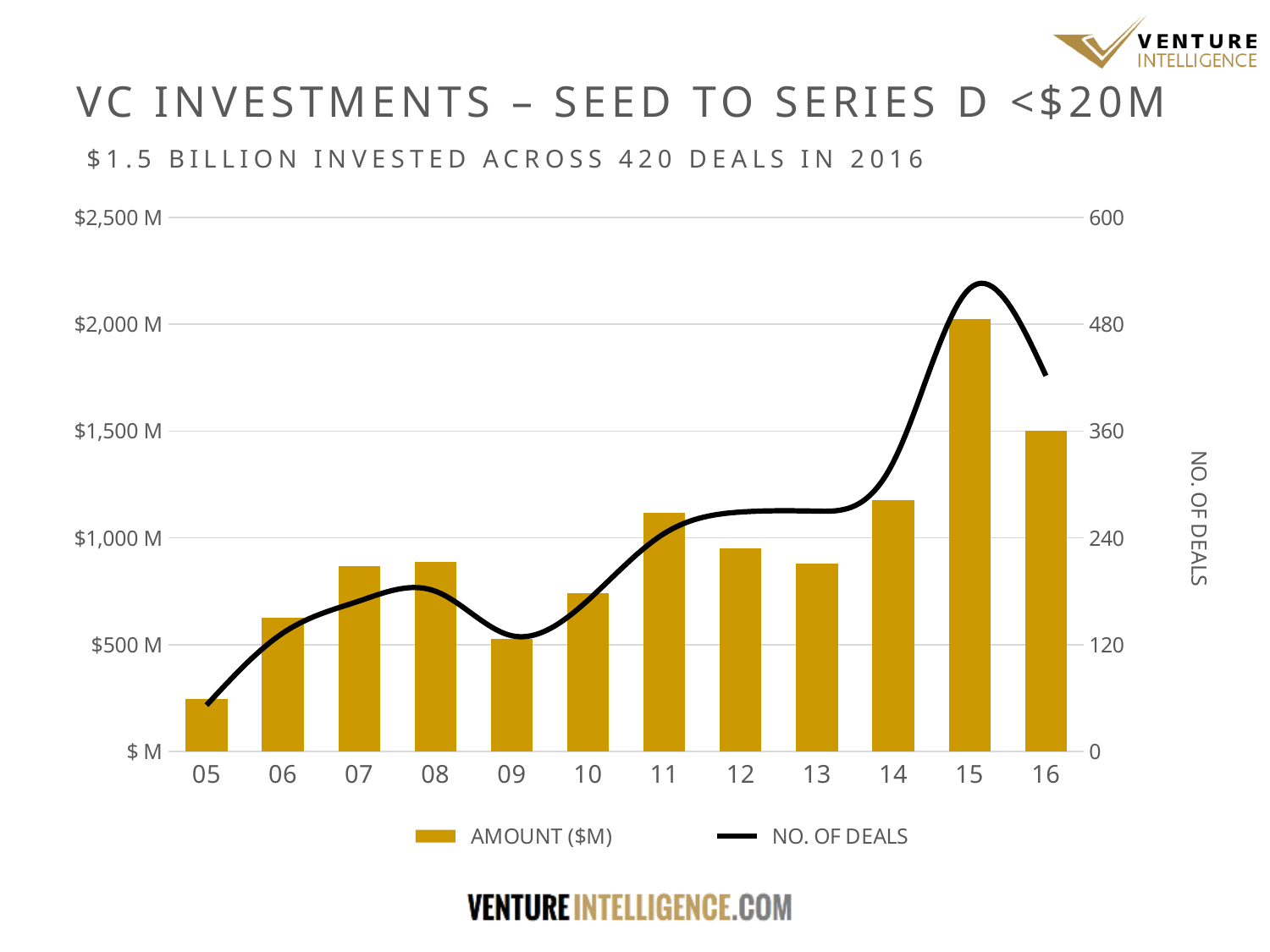
Which year has the lowest AMOUNT ($M) bar? 05 Is the AMOUNT ($M) for 14 greater or less than $1,000 M? greater What kind of chart is this? Combination bar and line chart Does the AMOUNT ($M) rise or fall from 05 to 08? rise Is the AMOUNT ($M) for 07 greater or less than $500 M? greater How many series does the legend list? 2 Which year has the highest AMOUNT ($M) bar? 15 Is the AMOUNT ($M) for 09 greater or less than $1,000 M? less Which year has a larger AMOUNT ($M), 11 or 12? 11 In which year does the NO. OF DEALS line reach its peak? 15 How many years are shown on the x axis? 12